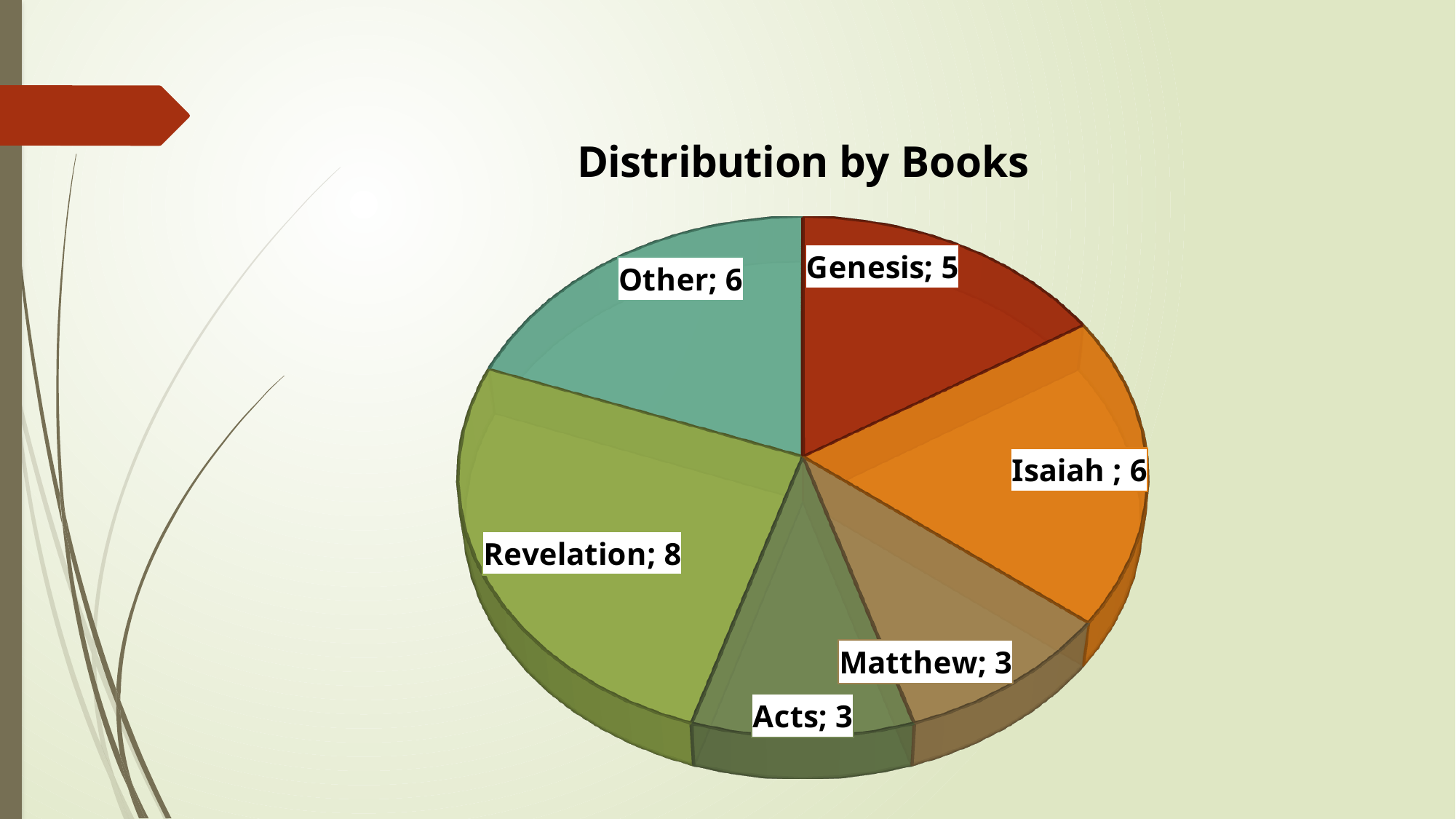
What is the value for Isaiah? 6 What is the value for Matthew? 3 Which is larger, the value for Isaiah or the value for Acts? Isaiah What kind of chart is shown on the slide? pie chart Which two slices share the smallest value? Matthew and Acts What is the difference between the values for Revelation and Genesis? 3 Which book has the largest slice of the pie? Revelation What is the title of the chart? Distribution by Books What is the total of all the slice values in the pie chart? 31 What is the value for Revelation? 8 How many slices does the pie chart have? 6 What is the value for Genesis? 5